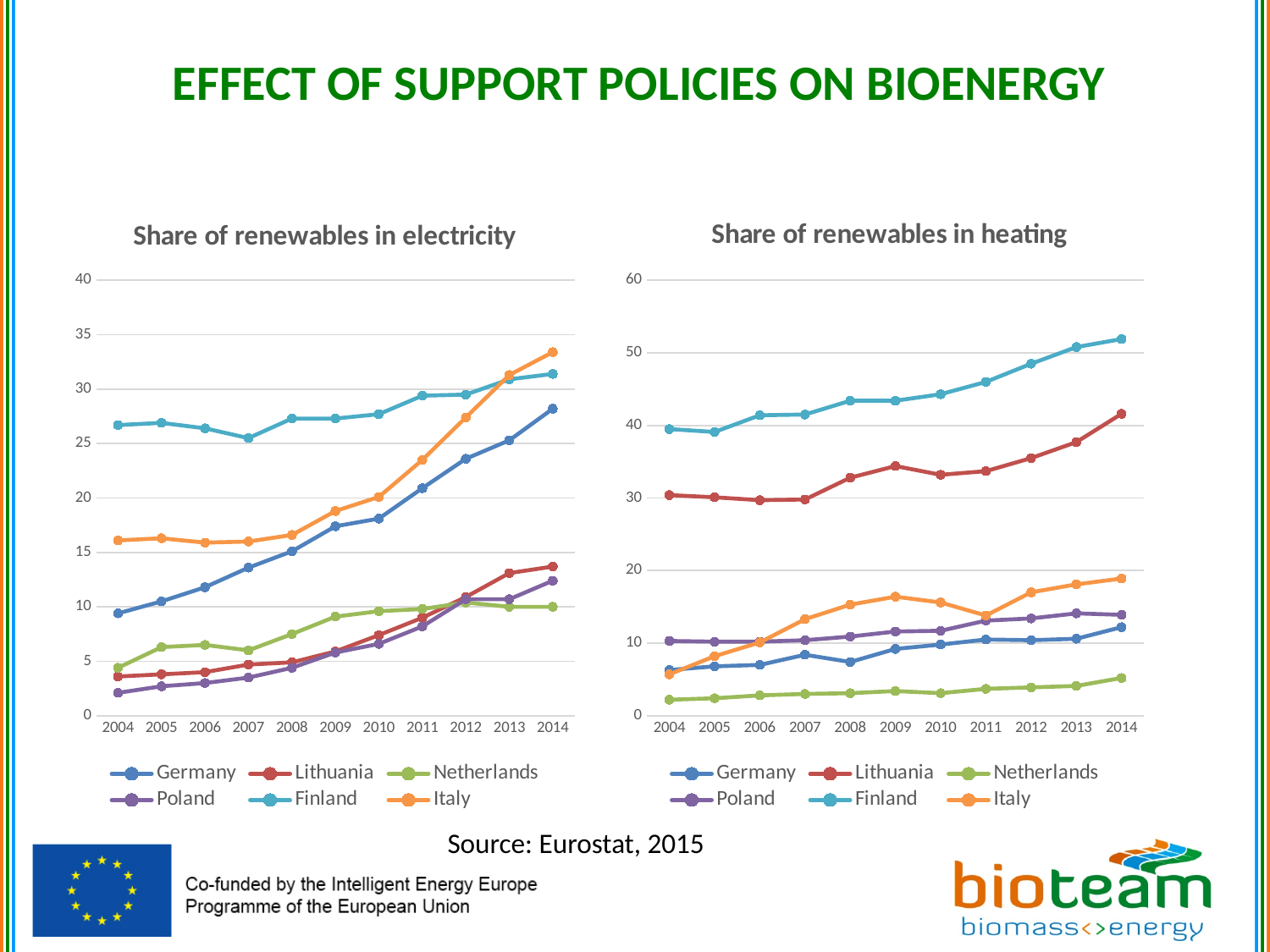
How many years are plotted along the x axis of the 'Share of renewables in electricity' chart? 11 What is the title of the chart on the right side of the slide? Share of renewables in heating In the 'Share of renewables in electricity' chart, does the value for Germany rise or fall from 2004 to 2014? rise In the 'Share of renewables in heating' chart, which country has the highest value in 2014? Finland How many series does the legend of the 'Share of renewables in heating' chart list? 6 In the 'Share of renewables in heating' chart, which is larger in 2004: the value for Germany or the value for Poland? Poland In the 'Share of renewables in heating' chart, which country has the lowest value in 2014? Netherlands In the 'Share of renewables in electricity' chart, which country has the highest value in 2004? Finland In the 'Share of renewables in electricity' chart, which country has the lowest value in 2004? Poland In the 'Share of renewables in electricity' chart, is the value for Germany in 2014 greater or less than 25? greater What kind of chart is the 'Share of renewables in electricity' chart? line chart In the 'Share of renewables in heating' chart, is the value for Finland in 2014 greater or less than 50? greater